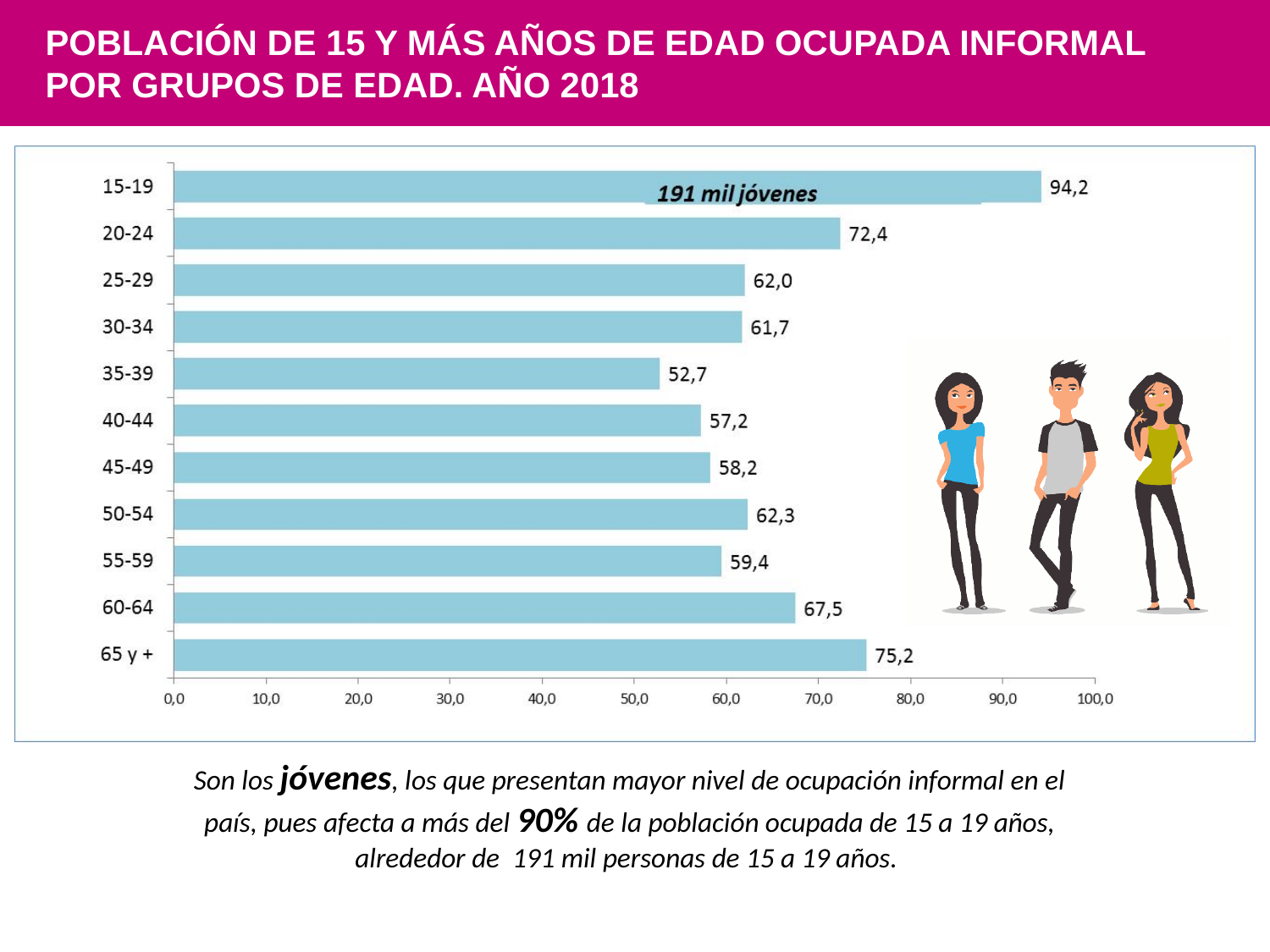
Which age group has the lowest value? 35-39 Which is larger, the value for 20-24 or the value for 65 y +? 65 y + What is the value for the 15-19 age group? 94,2 Which age group has the highest value? 15-19 What is the difference between the values for 65 y + and 60-64? 7,7 Is the value for 60-64 greater or less than 60,0? greater What is the value for the 65 y + age group? 75,2 What is the value for the 35-39 age group? 52,7 What kind of chart is shown on the slide? bar chart What is the difference between the values for 15-19 and 20-24? 21,8 How many age groups are shown in the chart? 11 What annotation text is written on the bar for the 15-19 age group? 191 mil jóvenes